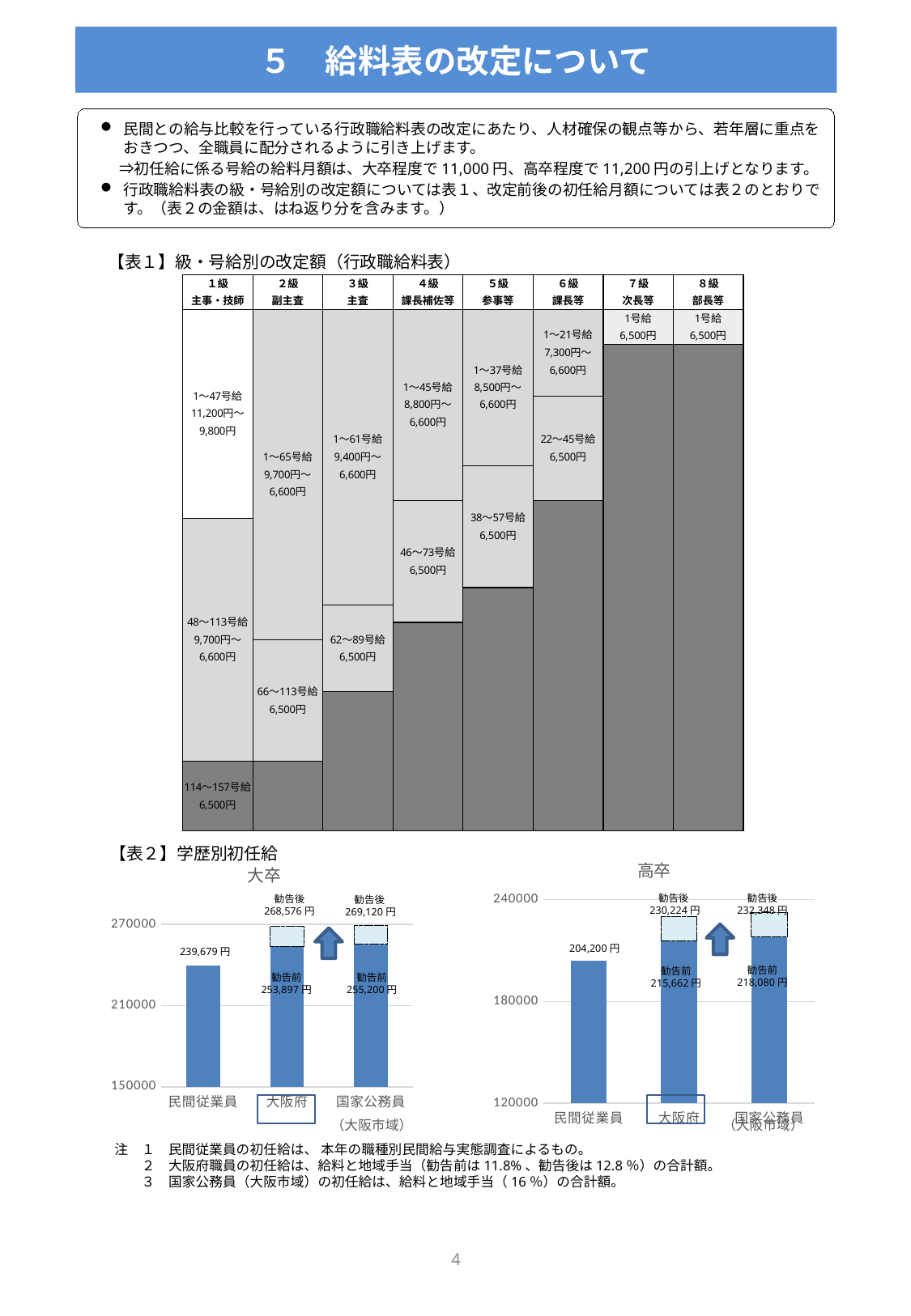
In the 高卒 chart, what is the 勧告前 value for 国家公務員 (大阪市域)? 218,080円 In the 大卒 chart, what is the difference between the 勧告後 and 勧告前 values for 大阪府? 14,679円 In the 高卒 chart, what is the value for 民間従業員? 204,200円 How many categories are shown on the x axis of the 高卒 chart? 3 What kind of chart is the 大卒 chart? bar chart In the 大卒 chart, which is larger: the 勧告後 value for 大阪府 or the 勧告後 value for 国家公務員 (大阪市域)? 国家公務員 (大阪市域) In the 大卒 chart, what is the 勧告後 value for 大阪府? 268,576円 In the 高卒 chart, what is the difference between the 勧告後 and 勧告前 values for 大阪府? 14,562円 In the 大卒 chart, is the value for 民間従業員 greater or less than 270000? less In the 高卒 chart, what is the difference between the 勧告後 value for 国家公務員 (大阪市域) and the value for 民間従業員? 28,148円 In the 高卒 chart, which category has the lowest value? 民間従業員 In the 大卒 chart, what is the value for 民間従業員? 239,679円